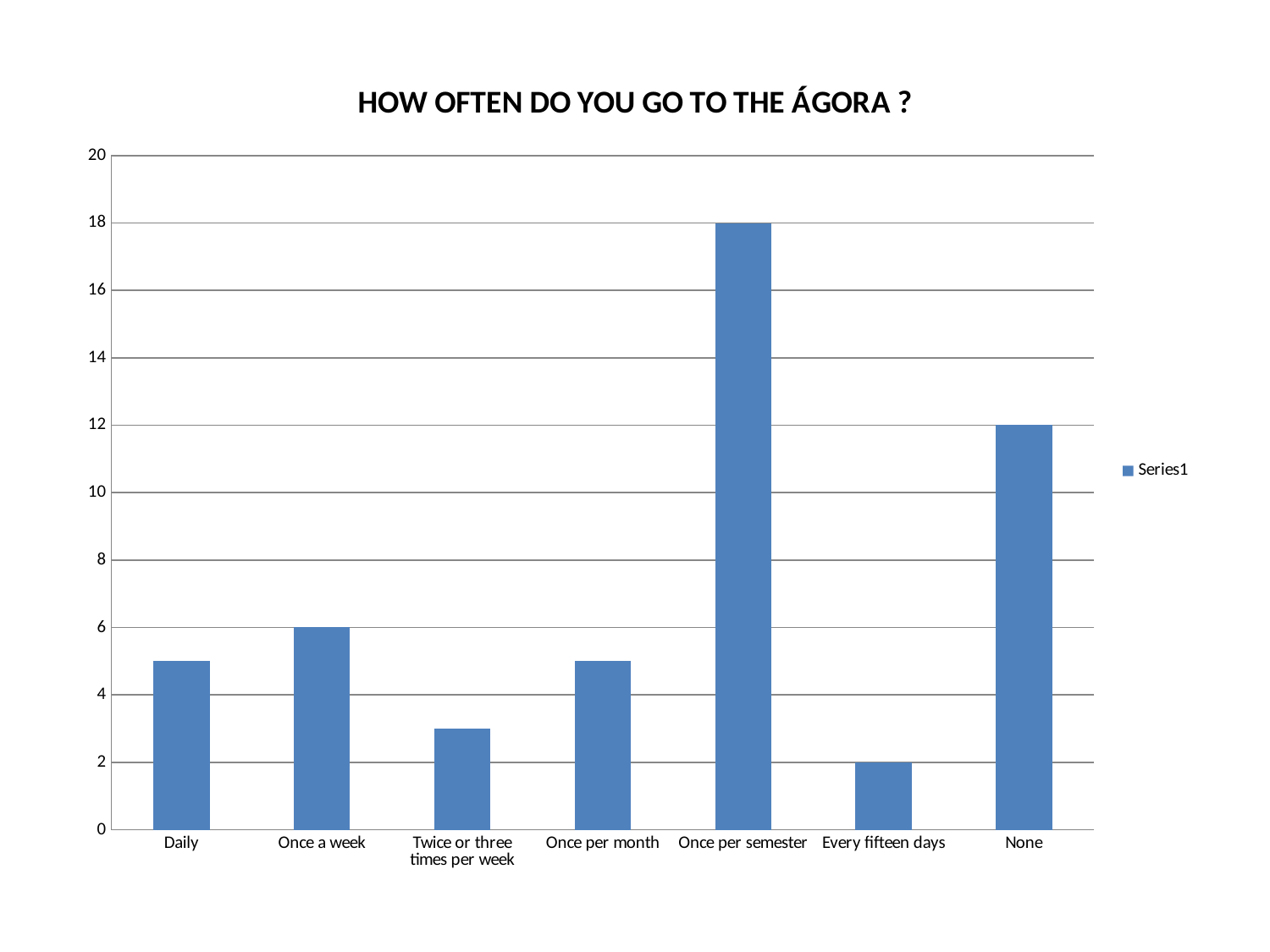
What is the value for Every fifteen days? 2 What is the value for None? 12 Which category has the lowest value? Every fifteen days Which is larger, the value for None or the value for Once a week? None What kind of chart is shown on the slide? Bar chart Is the value for Daily greater or less than 4? greater What is the difference between the values for Once per semester and None? 6 What is the value for Once per semester? 18 Which category has the highest value? Once per semester Is the value for Twice or three times per week greater or less than 4? less What is the value for Once a week? 6 How many categories are shown on the x axis? 7